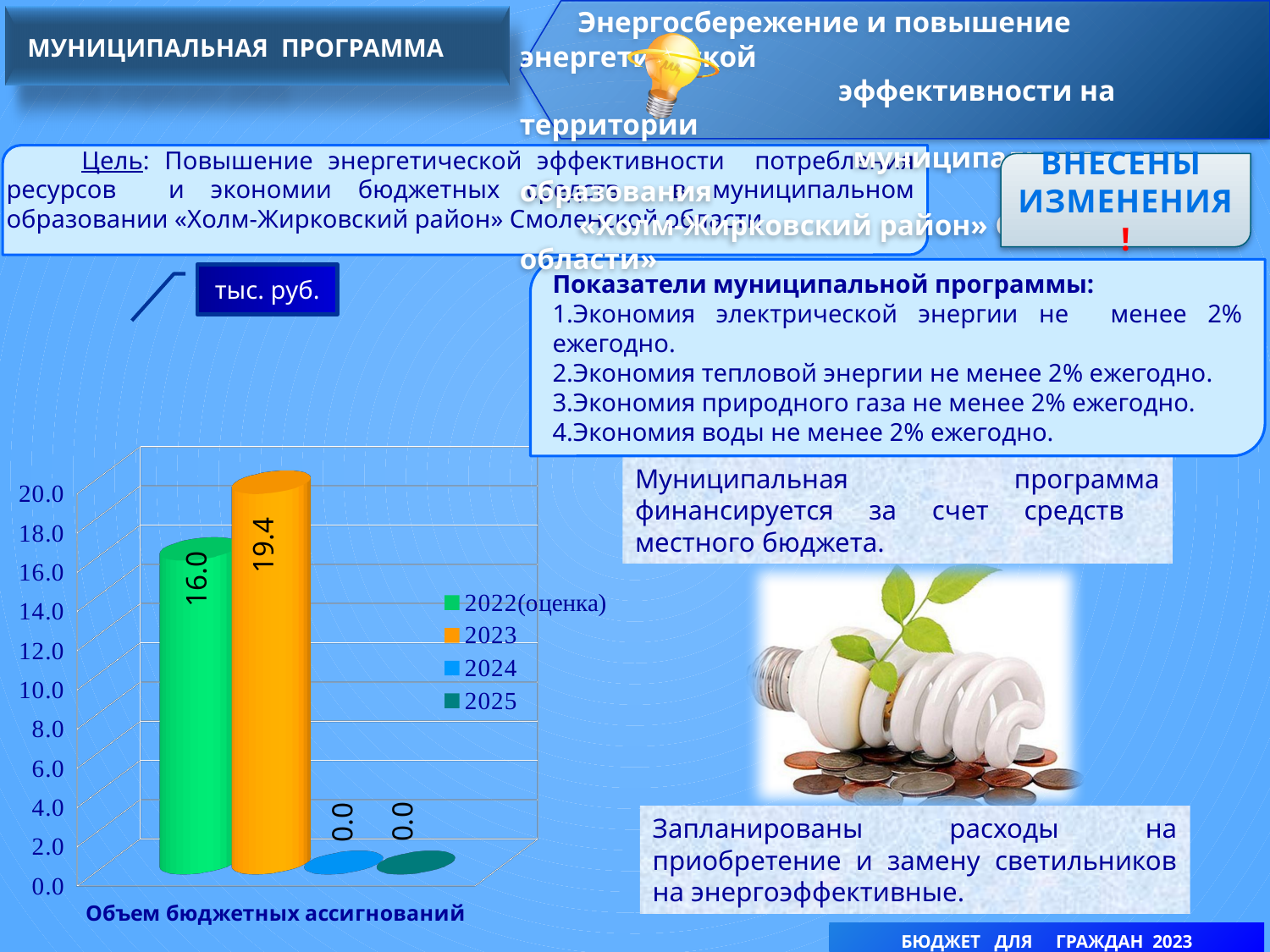
What is the value for 2025 in the chart? 0.0 Is the value for 2022(оценка) greater or less than 18.0? less What kind of chart is shown on the slide? bar chart What is the value for 2023 in the chart? 19.4 What is the category label shown below the chart? Объем бюджетных ассигнований How many series does the chart legend list? 4 Which is larger, the value for 2022(оценка) or the value for 2023? 2023 What unit is indicated for the chart values? тыс. руб. What is the value for 2024 in the chart? 0.0 What is the value for 2022(оценка) in the chart? 16.0 Which series has the highest value in the chart? 2023 What is the difference between the values for 2023 and 2022(оценка)? 3.4